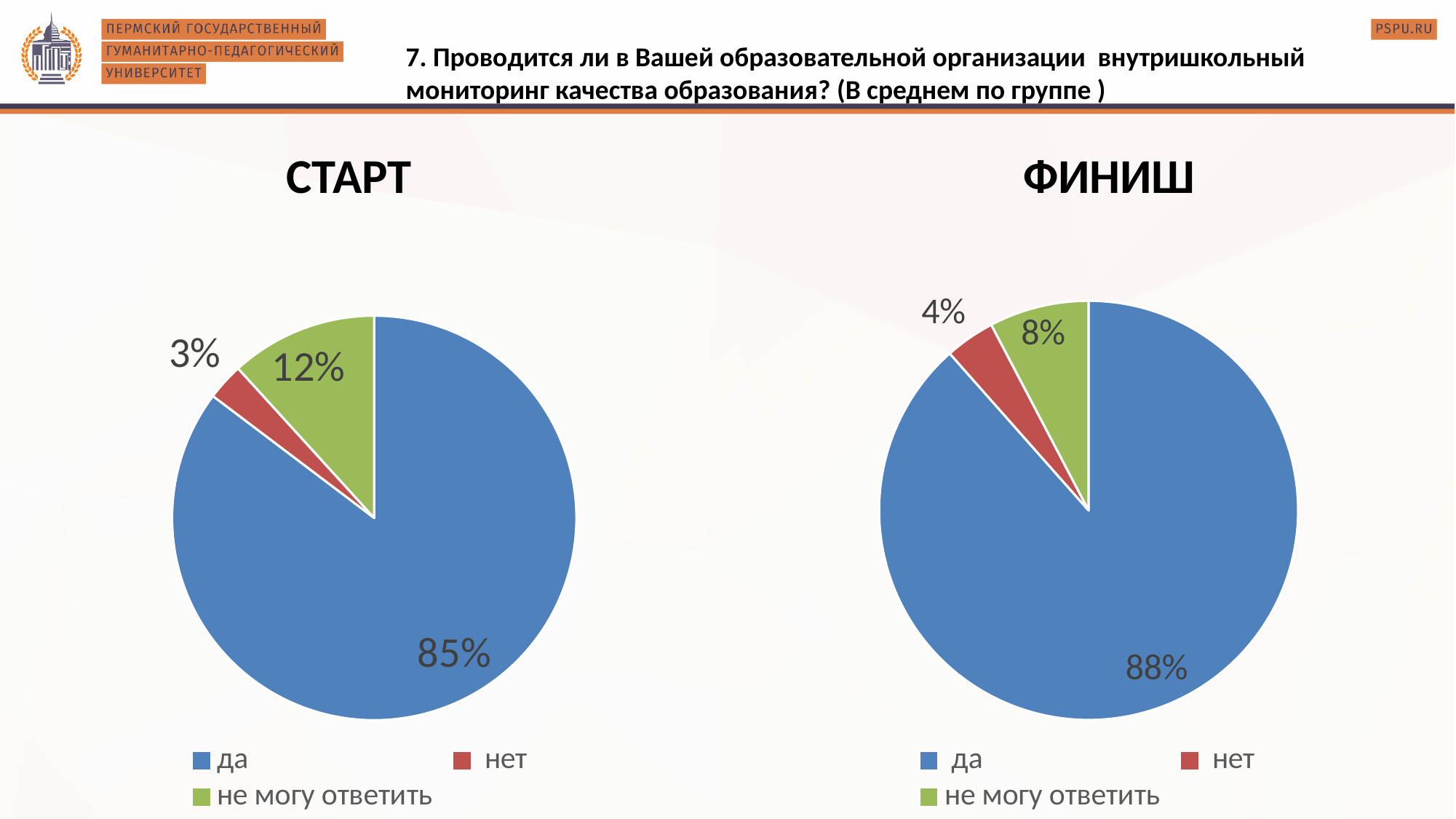
In the ФИНИШ pie chart, what share is labelled for "да"? 88% What type of chart is used for the СТАРТ data? Pie chart How many slices does the СТАРТ pie chart have? 3 In the ФИНИШ pie chart, which category has the largest slice? да What is the difference between the "да" share in the ФИНИШ chart and the "да" share in the СТАРТ chart? 3% In the СТАРТ pie chart, which category has the smallest slice? нет In the ФИНИШ chart, what colour represents "нет"? Red How many entries does the legend of the ФИНИШ chart list? 3 In the ФИНИШ pie chart, what share is labelled for "нет"? 4% In the СТАРТ pie chart, what share is labelled for "да"? 85% In the СТАРТ pie chart, what share is labelled for "не могу ответить"? 12% Which is larger: the "не могу ответить" share in the СТАРТ chart or in the ФИНИШ chart? СТАРТ